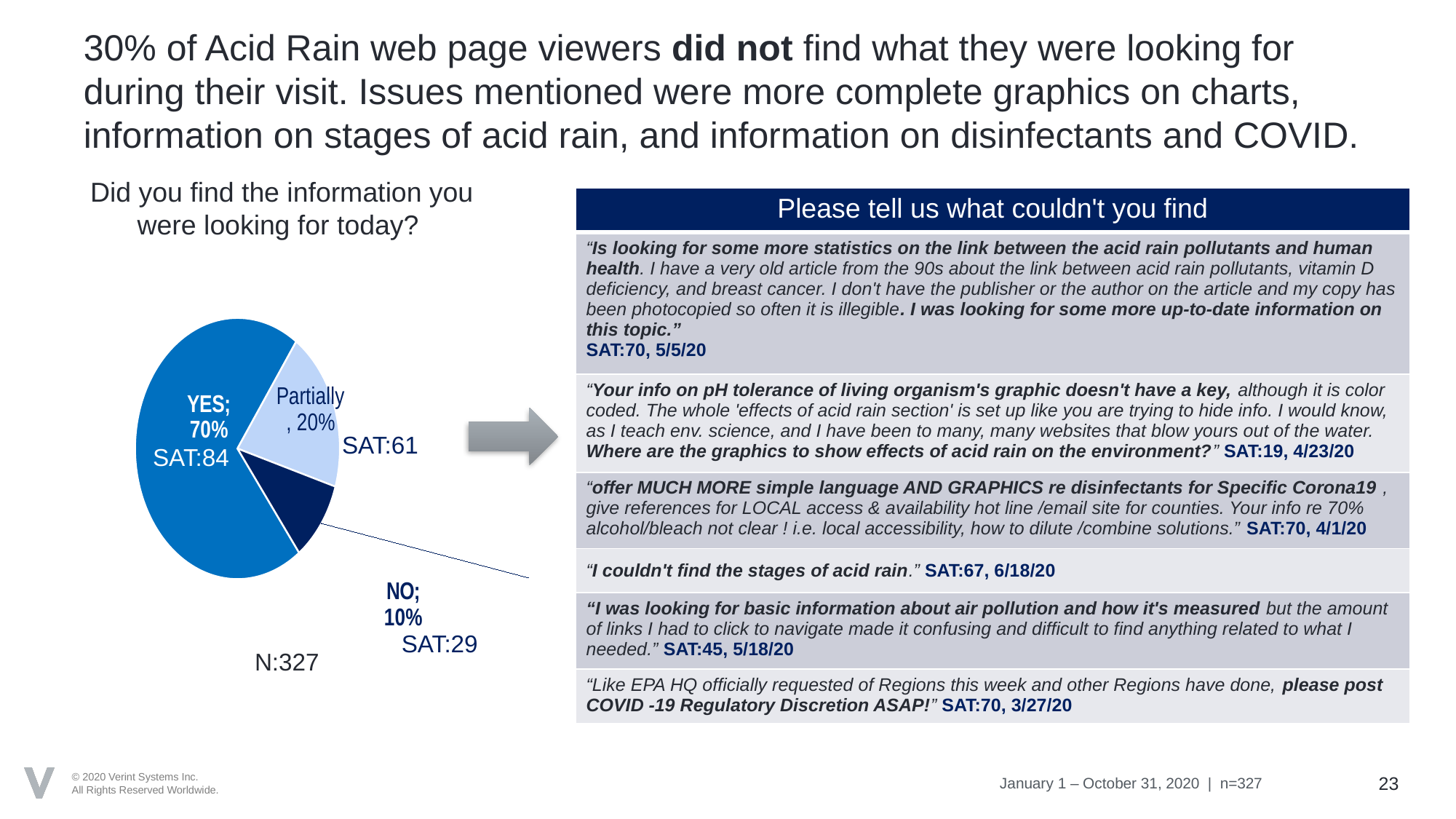
Which response has the smallest share of the pie? NO Which slice is larger, Partially or NO? Partially What is the SAT score shown for the NO slice? 29 What percentage of respondents answered Partially? 20% What percentage of respondents answered YES? 70% Which response has the largest share of the pie? YES What percentage of respondents answered NO? 10% What is the difference in percentage points between the YES and Partially slices? 50 What kind of chart is shown on the slide? pie chart What is the question title shown above the pie chart? Did you find the information you were looking for today? What is the SAT score shown for the YES slice? 84 How many slices does the pie chart have? 3